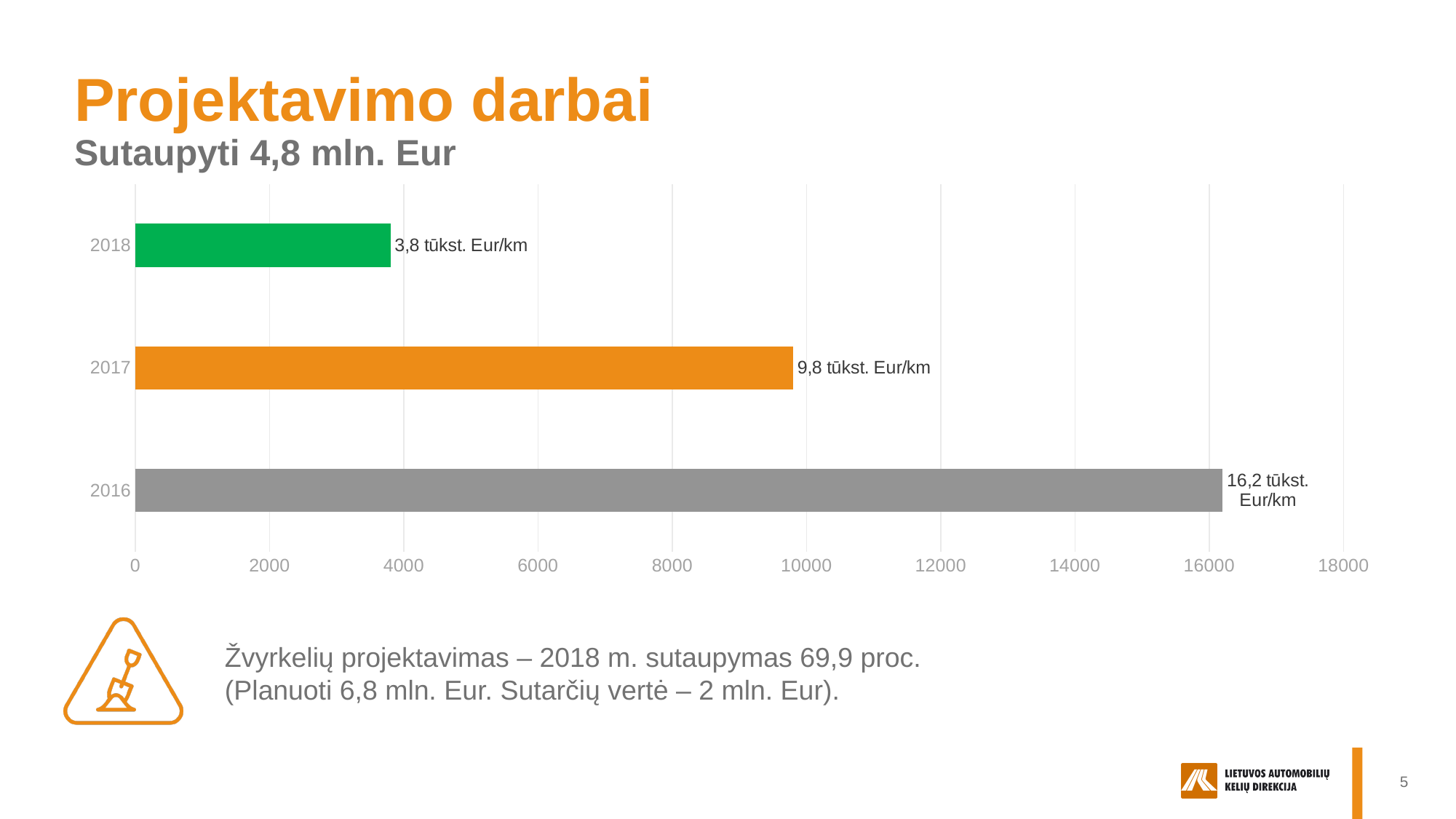
Which year has the highest value? 2016 What is the value shown for 2016? 16,2 tūkst. Eur/km What is the value shown for 2018? 3,8 tūkst. Eur/km Which is larger, the value for 2017 or the value for 2018? 2017 What is the difference between the values for 2016 and 2017, in tūkst. Eur/km? 6,4 What kind of chart is shown on the slide? bar chart Which year has the lowest value? 2018 What is the difference between the values for 2017 and 2018, in tūkst. Eur/km? 6,0 Do the values rise or fall from 2016 to 2018? fall What is the value shown for 2017? 9,8 tūkst. Eur/km How many years are shown in the chart? 3 Is the value for 2016 greater or less than 14000? greater